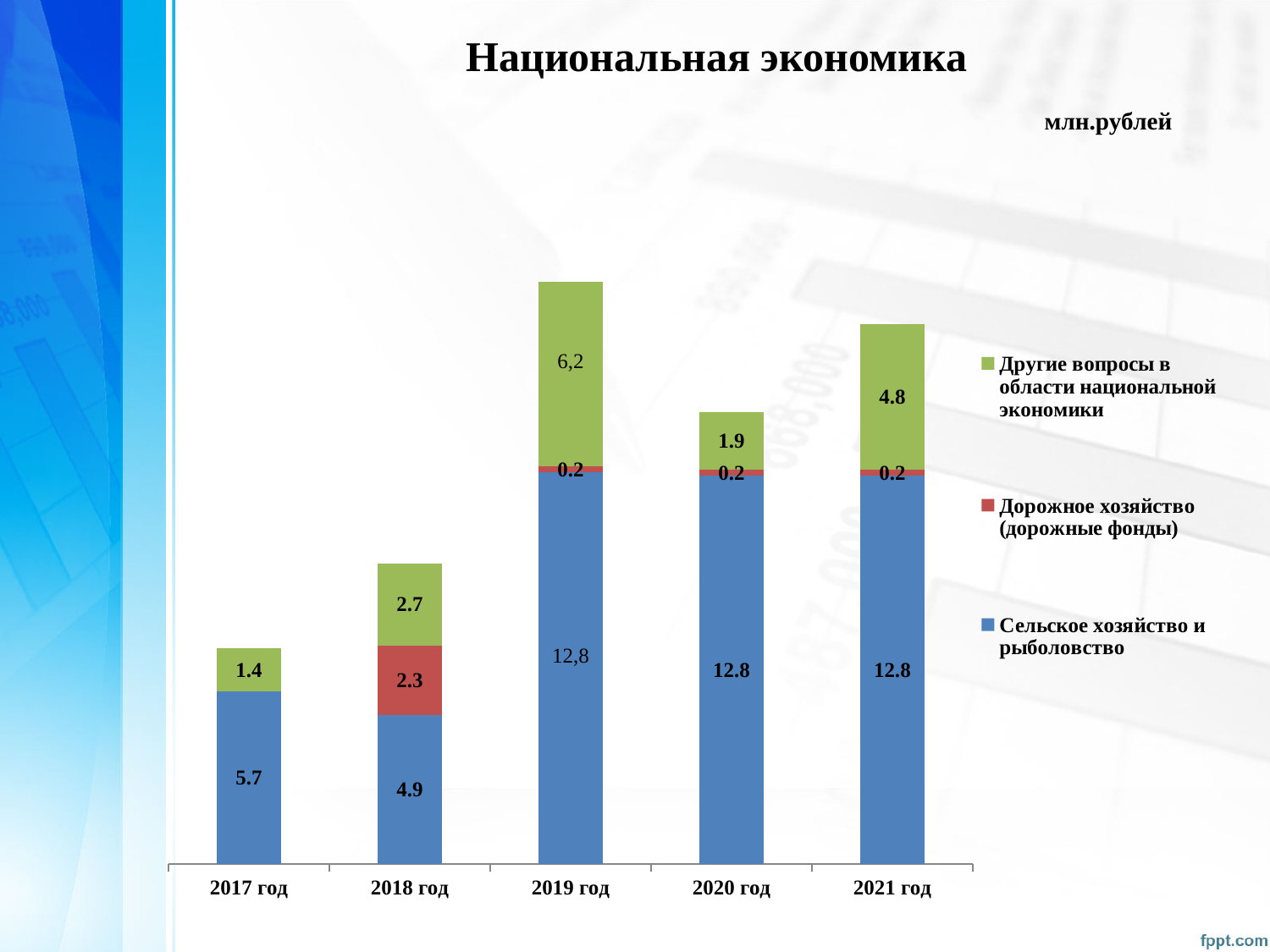
What is the total of the stacked bar for 2018 год? 9.9 Which year has the lowest value for Сельское хозяйство и рыболовство? 2018 год What is the value for Сельское хозяйство и рыболовство in 2017 год? 5.7 What unit is stated for the values on the chart? млн.рублей Which year has the highest value for Другие вопросы в области национальной экономики? 2019 год What is the value for Дорожное хозяйство (дорожные фонды) in 2018 год? 2.3 What type of chart is shown on the slide? Stacked bar chart How many years are shown on the x axis? 5 What is the value for Другие вопросы в области национальной экономики in 2021 год? 4.8 How many series does the legend list? 3 What is the value for Другие вопросы в области национальной экономики in 2019 год? 6,2 What is the difference between the Другие вопросы в области национальной экономики values for 2021 год and 2020 год? 2.9